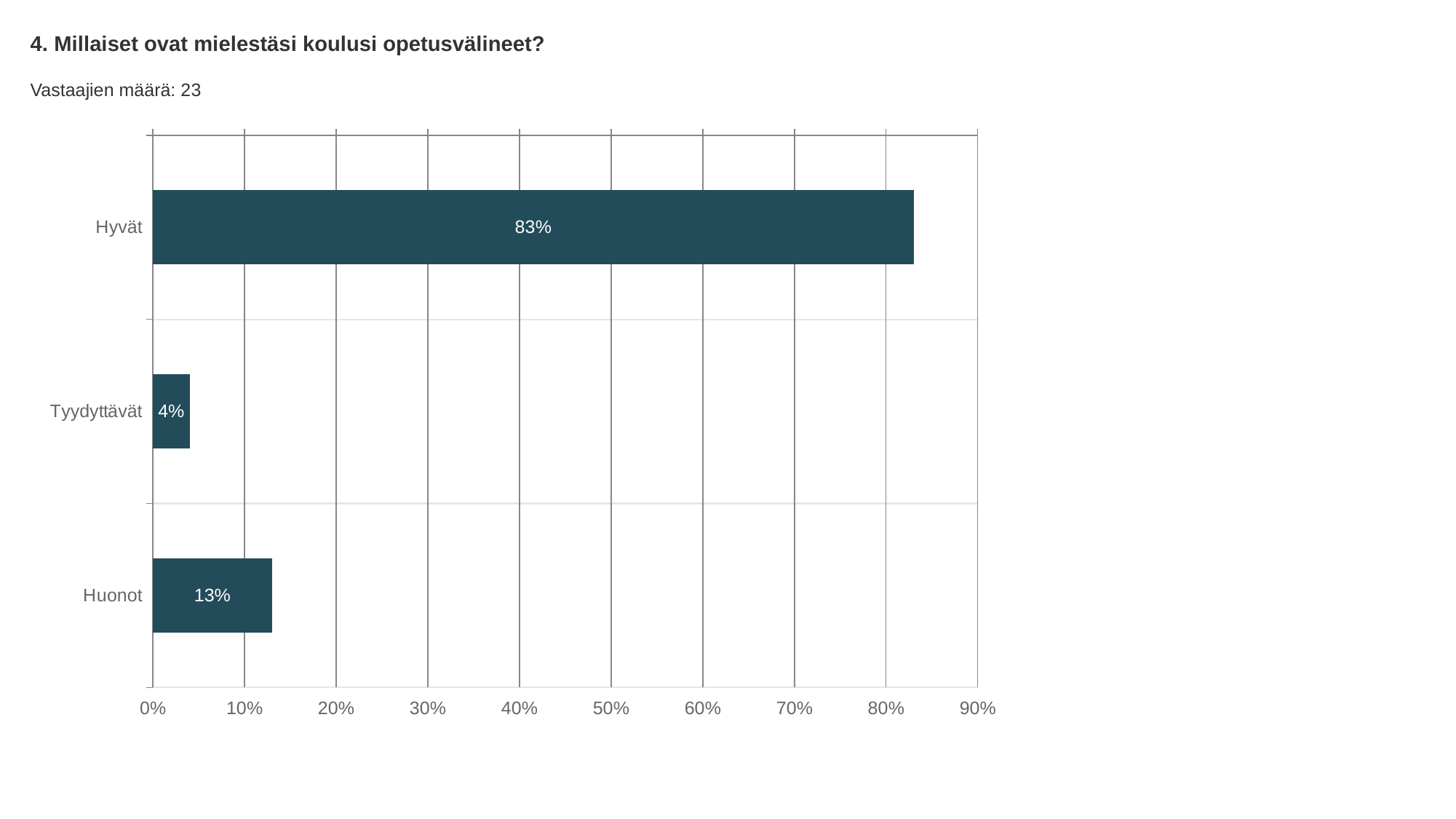
What kind of chart is shown on the slide? bar chart What is the value for Hyvät? 83% Which category has the highest value? Hyvät Which is larger, the value for Huonot or the value for Tyydyttävät? Huonot How many respondents does the slide report (Vastaajien määrä)? 23 What is the difference between the values for Huonot and Tyydyttävät? 9% Is the value for Hyvät greater or less than 80%? greater What is the value for Huonot? 13% Which category has the lowest value? Tyydyttävät How many categories are shown in the chart? 3 What is the value for Tyydyttävät? 4% What is the difference between the values for Hyvät and Huonot? 70%